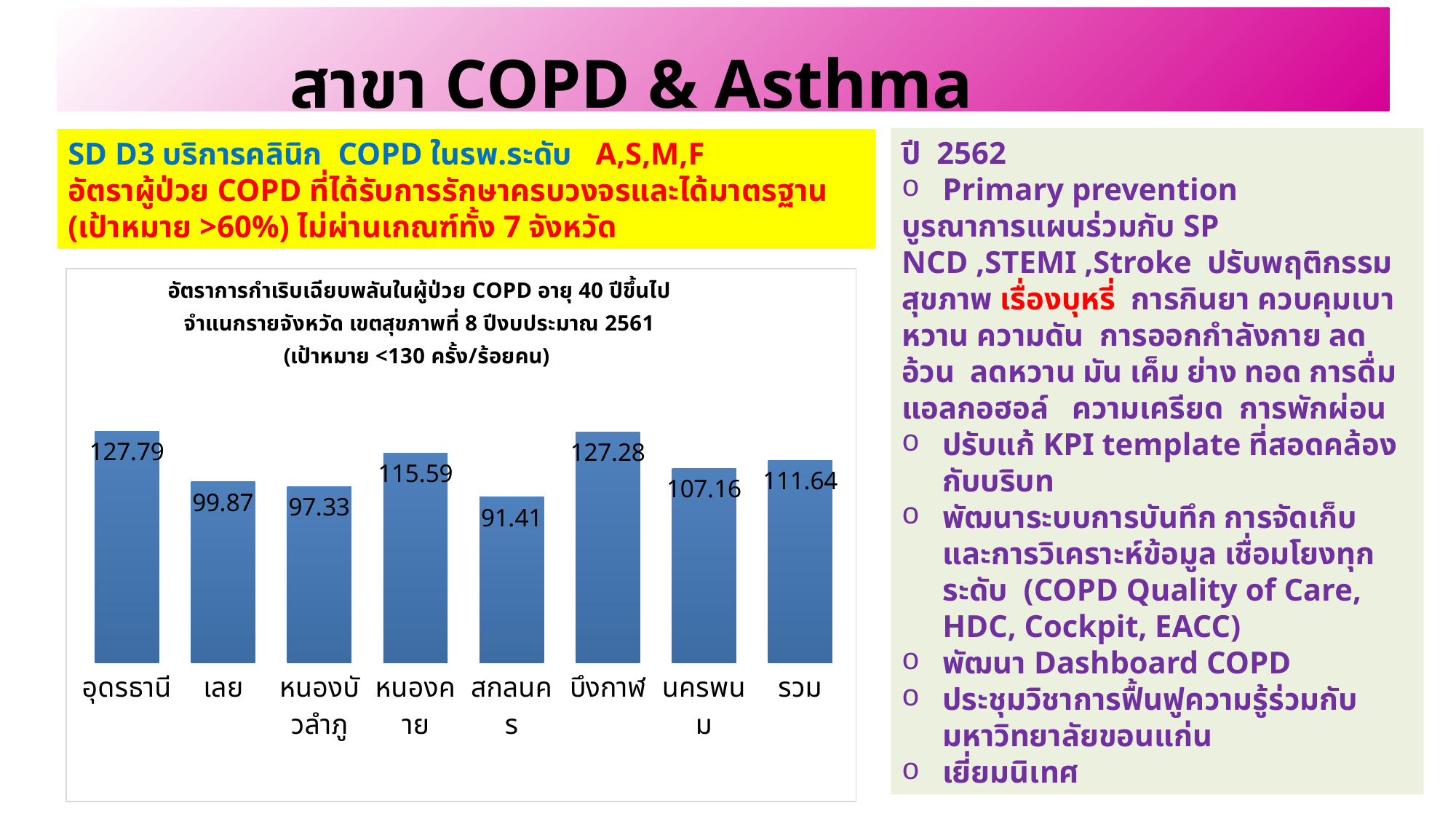
What is the difference between the values for หนองคาย and หนองบัวลำภู? 18.26 How many bars are shown in the chart? 8 Which is larger, the value for เลย or the value for นครพนม? นครพนม What is the value for อุดรธานี? 127.79 What target value is stated in the chart title? <130 ครั้ง/ร้อยคน What is the value for สกลนคร? 91.41 What is the value for รวม? 111.64 What kind of chart is shown on the slide? Bar chart Which category has the lowest value? สกลนคร What is the difference between the values for อุดรธานี and บึงกาฬ? 0.51 What is the value for นครพนม? 107.16 Which province has the highest value? อุดรธานี